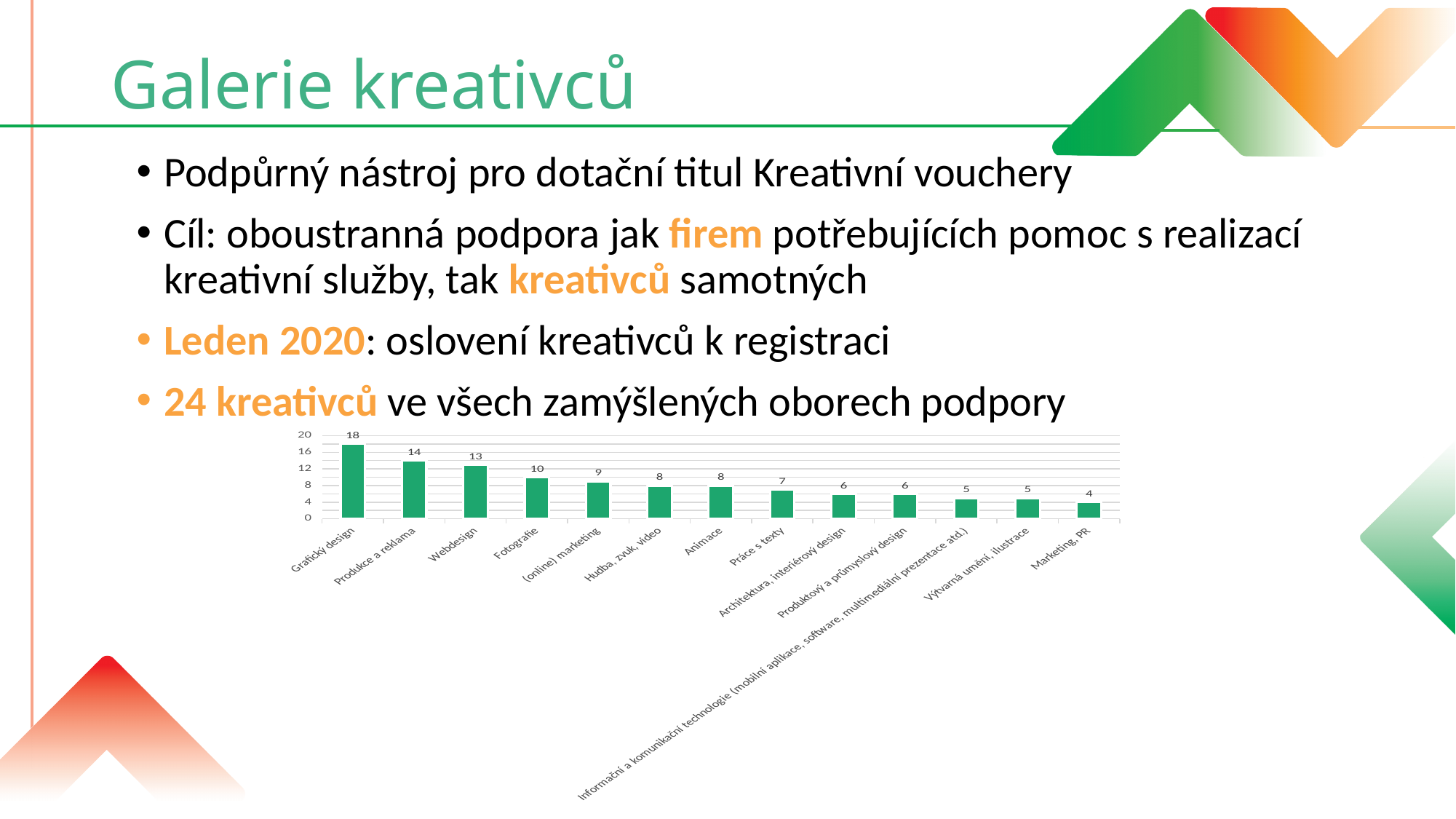
How many categories does the chart show? 13 What is the value for Práce s texty? 7 What colour are the bars in the chart? green What is the value for Webdesign? 13 What is the difference between the values for Grafický design and Produkce a reklama? 4 Which is larger, the value for Fotografie or the value for Animace? Fotografie What is the value for Grafický design? 18 Do the values rise or fall from left to right along the x axis? fall Which category has the lowest value? Marketing, PR What is the value for Fotografie? 10 Which category has the highest value? Grafický design What type of chart is shown on the slide? bar chart